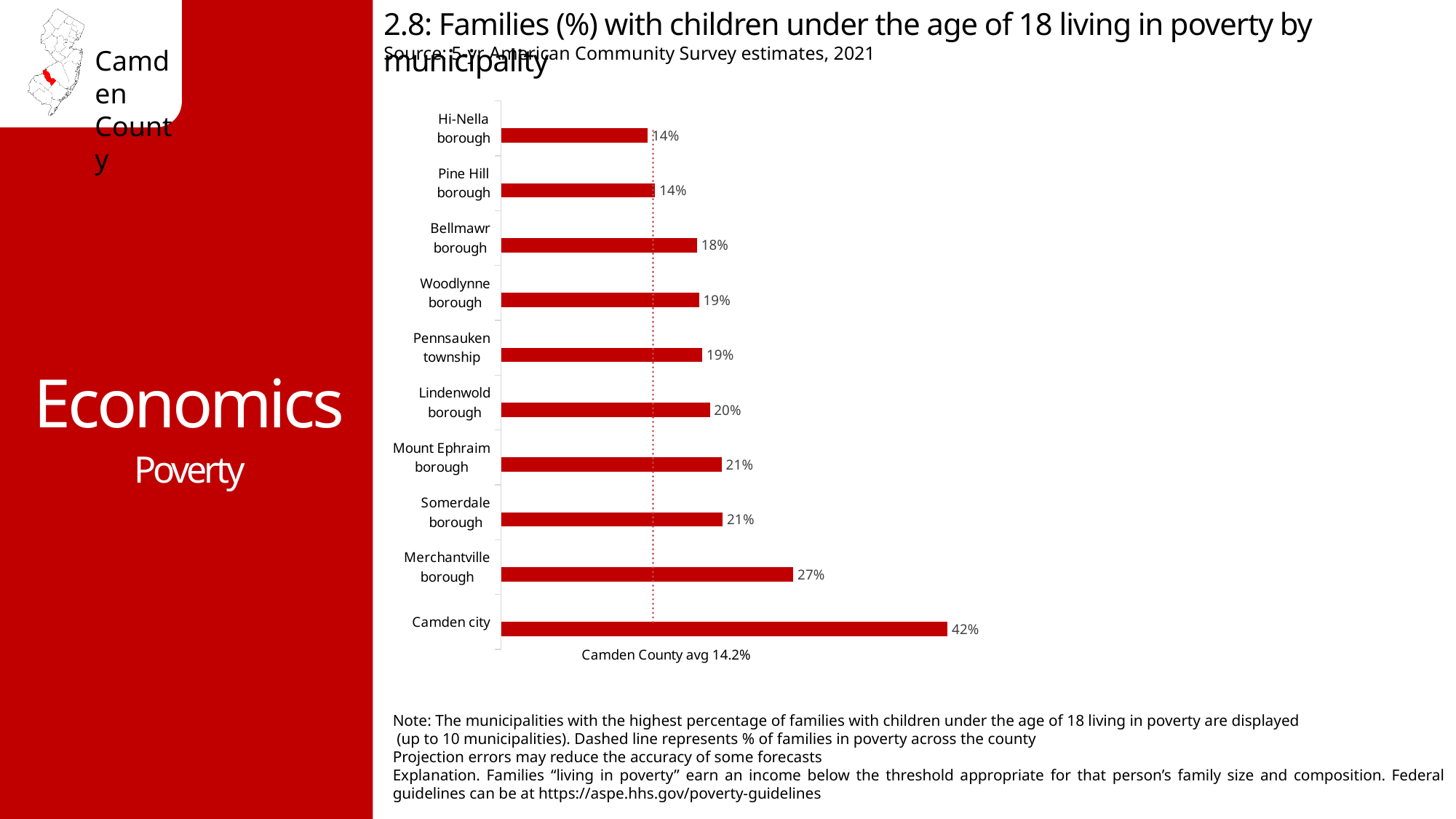
Which municipality has the highest percentage of families with children living in poverty? Camden city What is the value shown for Bellmawr borough? 18% What is the difference between Mount Ephraim borough and Woodlynne borough? 2 percentage points What type of chart is used on this slide? Bar chart Which has a higher value, Merchantville borough or Somerdale borough? Merchantville borough What is the value shown for Lindenwold borough? 20% What does the dashed vertical line on the chart represent? Camden County avg 14.2% Do the values increase or decrease going from the top bar to the bottom bar? Increase What is the value shown for Merchantville borough? 27% What percentage of families with children under 18 live in poverty in Camden city? 42% How many percentage points higher is Camden city than Merchantville borough? 15 How many municipalities are shown in the chart? 10